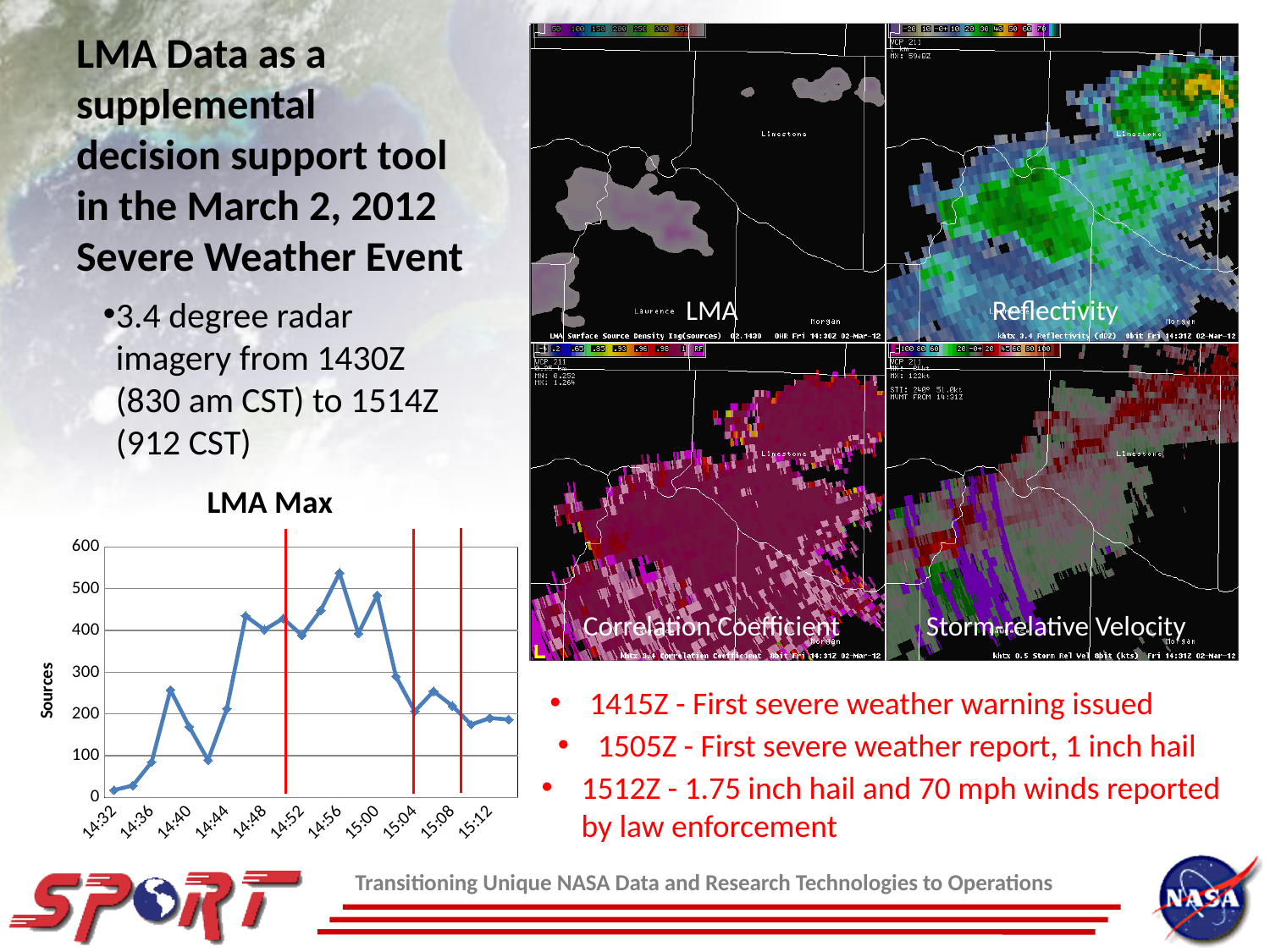
Is the value at 14:56 on the LMA Max chart greater or less than 500? greater At which time does the LMA Max chart reach its highest value? 14:56 Is the value at 15:12 on the LMA Max chart greater or less than 300? less What is the title of the chart on the slide? LMA Max Do the values on the LMA Max chart rise or fall between 15:00 and 15:10? fall How many time labels are shown on the x axis of the LMA Max chart? 11 On the LMA Max chart, which is larger: the value at 14:56 or the value at 15:04? 14:56 What is the label on the vertical axis of the LMA Max chart? Sources What kind of chart is the LMA Max chart? line chart At which time does the LMA Max chart show its lowest value? 14:32 Is the value at 14:32 on the LMA Max chart greater or less than 100? less